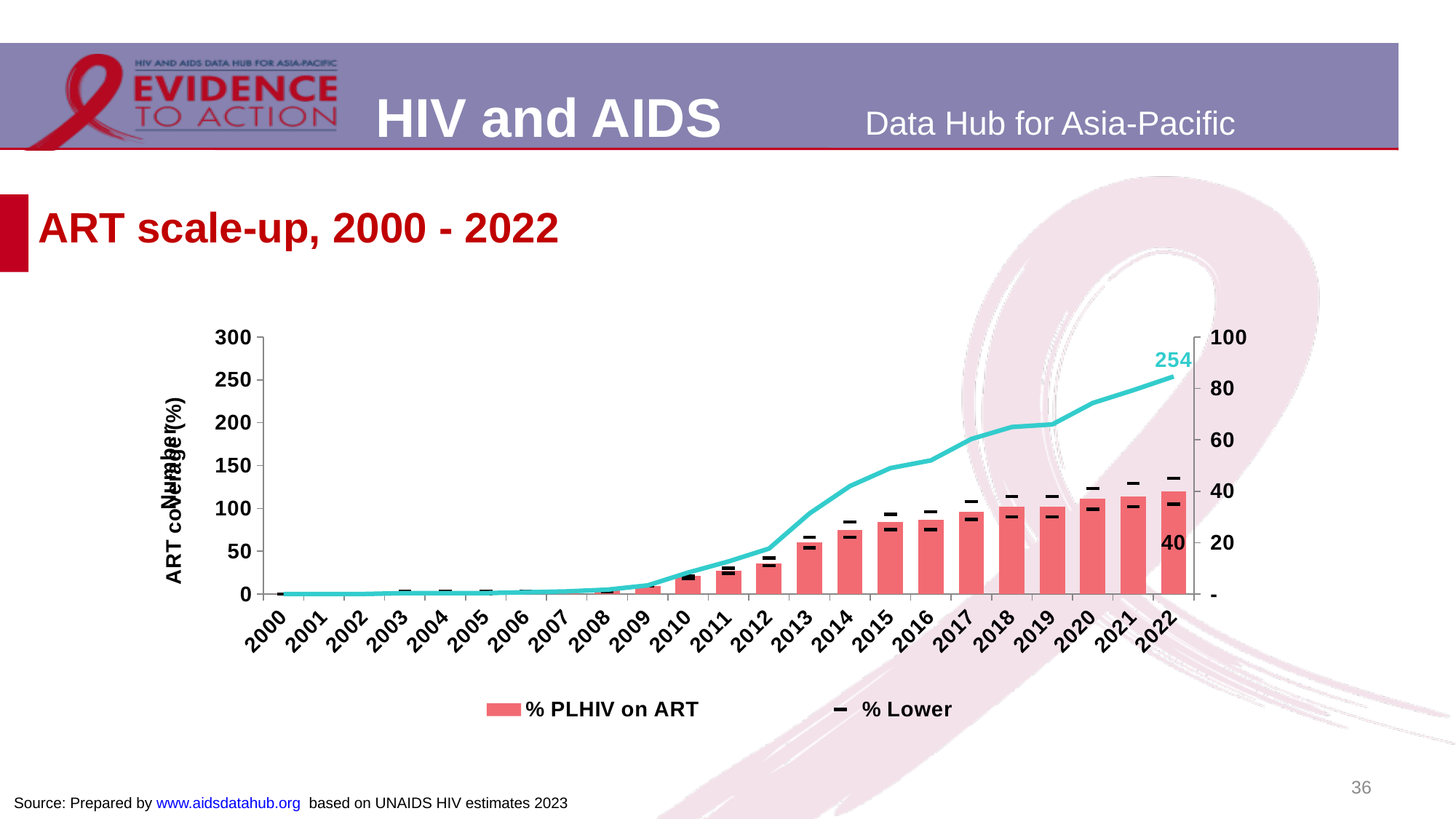
How many years are shown along the x axis? 23 Is the % PLHIV on ART bar for 2010 greater or less than 20 on the right axis? less Is the line value for 2014 greater or less than 100 on the left axis? greater What value is labelled on the % PLHIV on ART bar for 2022? 40 What kind of chart is used to show % PLHIV on ART? bar chart Do the % PLHIV on ART bars generally rise or fall from 2000 to 2022? rise Which is larger, the % PLHIV on ART bar for 2022 or for 2010? 2022 How many series does the legend list? 2 What is the title of the chart on the slide? ART scale-up, 2000 - 2022 Which year has the tallest % PLHIV on ART bar? 2022 What value is labelled on the line series for 2022? 254 What colour are the % PLHIV on ART bars? red